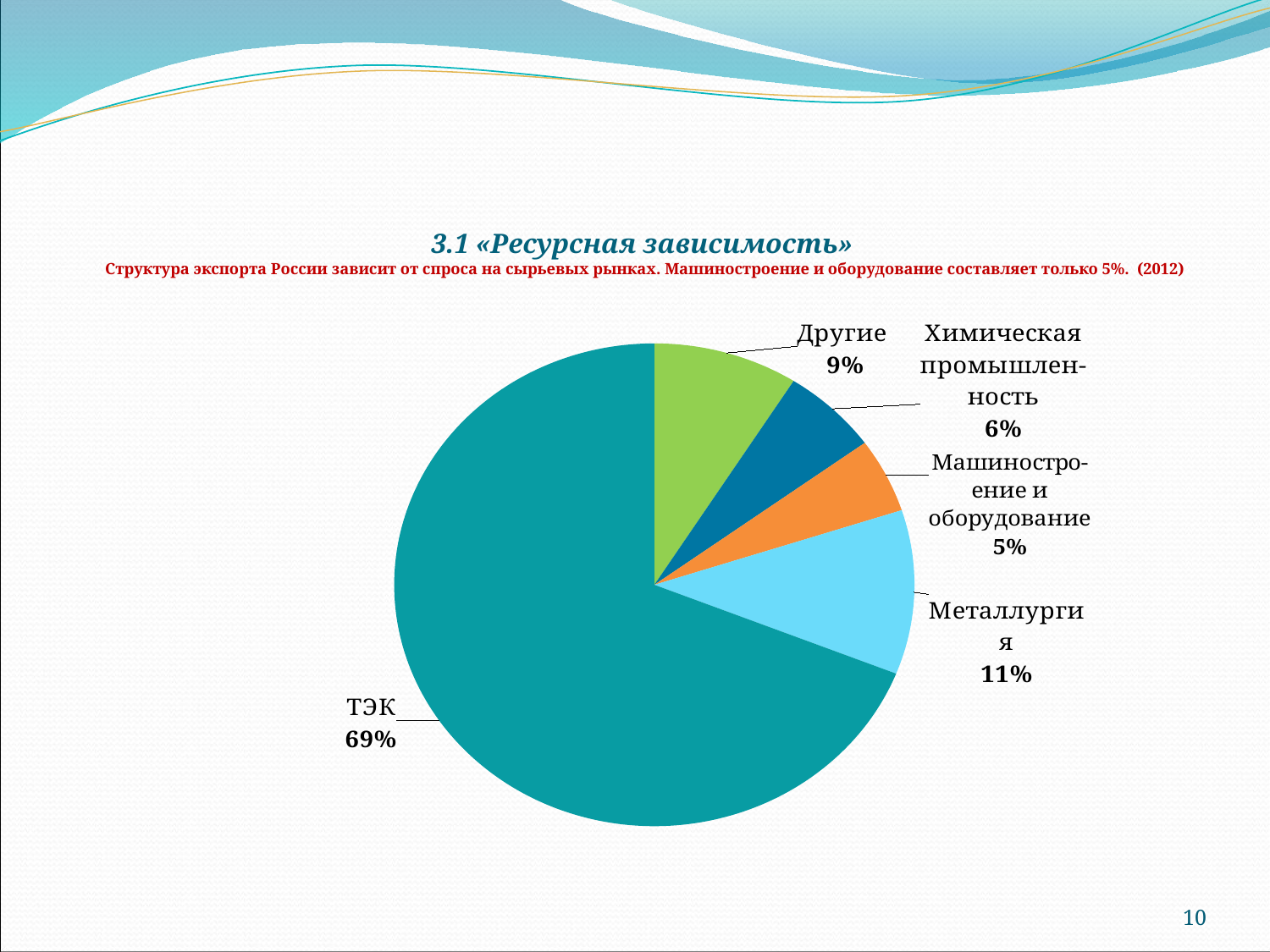
How many slices does the pie chart have? 5 Which is larger, the share of Другие or the share of Химическая промышленность? Другие What share of the pie does Машиностроение и оборудование have? 5% What kind of chart is shown on the slide? pie chart What share of the pie does ТЭК have? 69% What share of the pie does Химическая промышленность have? 6% Which category has the largest slice of the pie? ТЭК What is the difference between the shares of ТЭК and Металлургия? 58% What share of the pie does Металлургия have? 11% Which category has the smallest slice of the pie? Машиностроение и оборудование What colour is the ТЭК slice? teal What share of the pie does Другие have? 9%